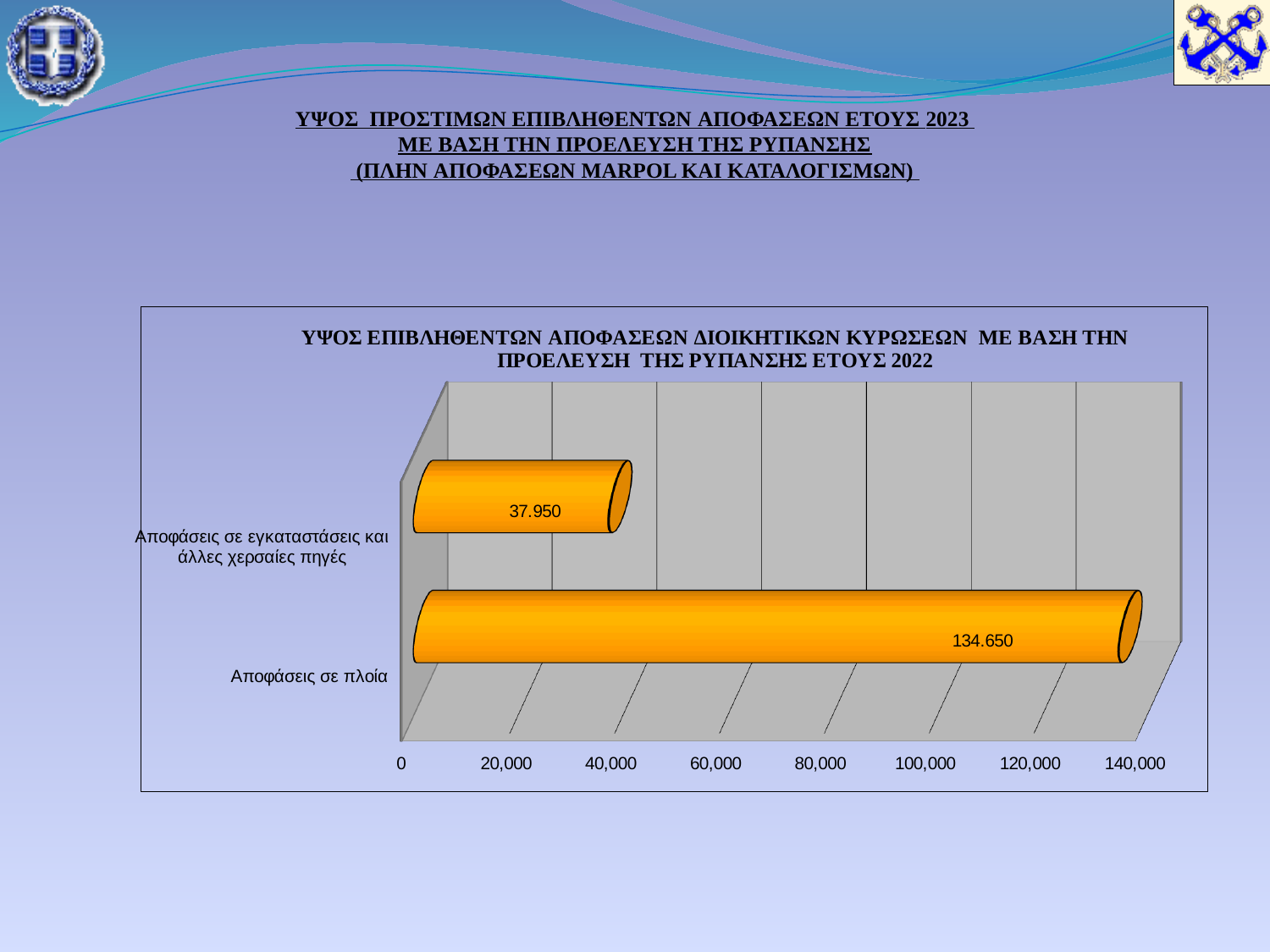
What is the maximum value shown on the horizontal axis of the chart? 140,000 Which year is mentioned in the chart's title? 2022 What is the difference between the value for Αποφάσεις σε πλοία and the value for Αποφάσεις σε εγκαταστάσεις και άλλες χερσαίες πηγές? 96.700 What is the value for Αποφάσεις σε πλοία? 134.650 What kind of chart is shown on the slide? Bar chart What is the value for Αποφάσεις σε εγκαταστάσεις και άλλες χερσαίες πηγές? 37.950 Which category has the lowest value? Αποφάσεις σε εγκαταστάσεις και άλλες χερσαίες πηγές Is the value for Αποφάσεις σε πλοία greater or less than 120,000? greater Is the value for Αποφάσεις σε εγκαταστάσεις και άλλες χερσαίες πηγές greater or less than 40,000? less Which category has the highest value? Αποφάσεις σε πλοία Which is larger: the value for Αποφάσεις σε πλοία or the value for Αποφάσεις σε εγκαταστάσεις και άλλες χερσαίες πηγές? Αποφάσεις σε πλοία How many categories are shown in the chart? 2